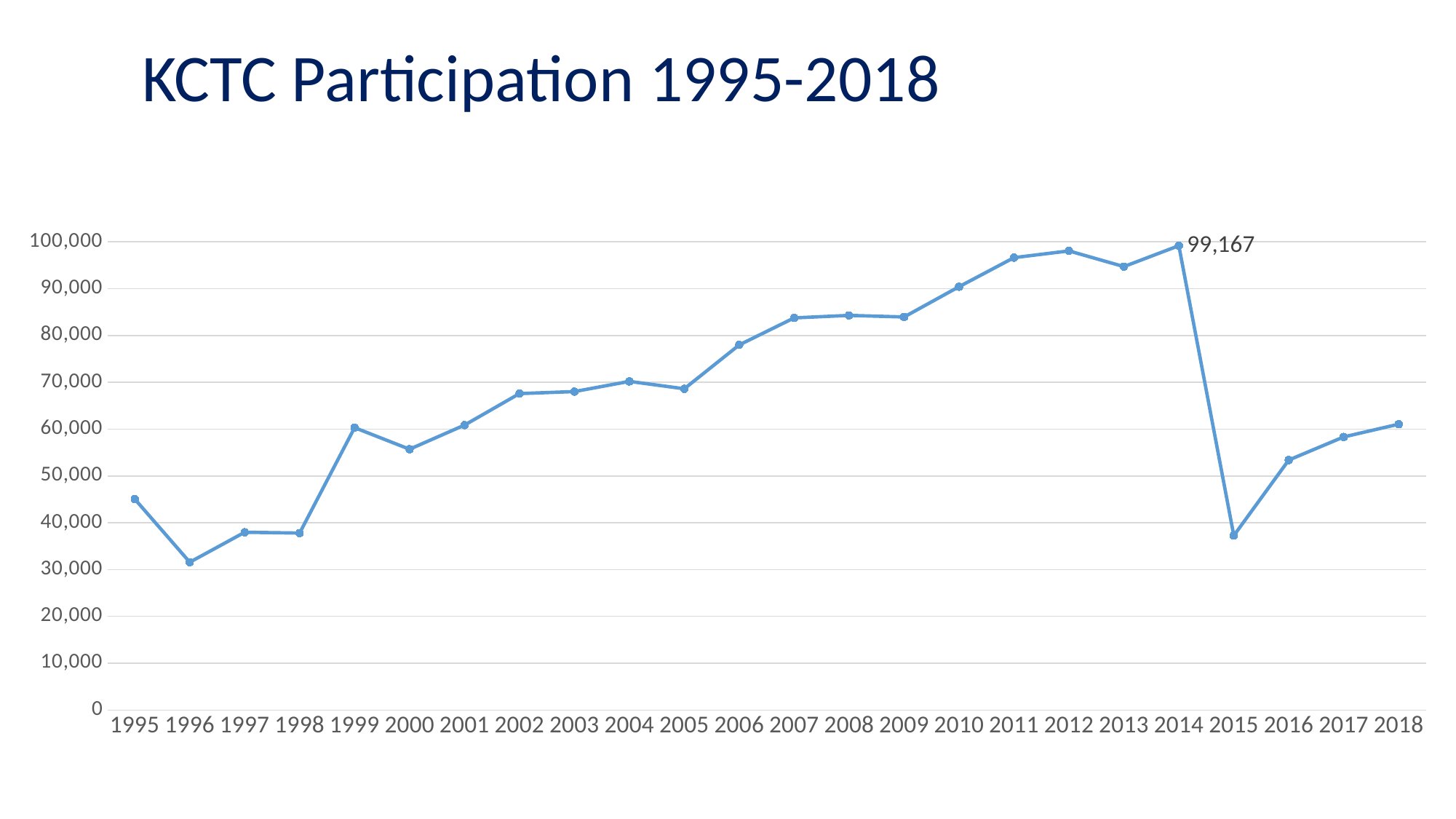
Is the value for 1995 greater or less than 40,000? greater Which year has the larger value, 2012 or 2013? 2012 Which year has the lowest participation? 1996 Is the value for 2015 greater or less than 40,000? less Which year has the larger value, 1999 or 2000? 1999 How many years are plotted on the chart? 24 Does participation rise or fall from 2014 to 2015? fall What kind of chart is shown on the slide? line chart Is the value for 2006 greater or less than 70,000? greater Which year has the highest participation? 2014 What is the value for 2014? 99,167